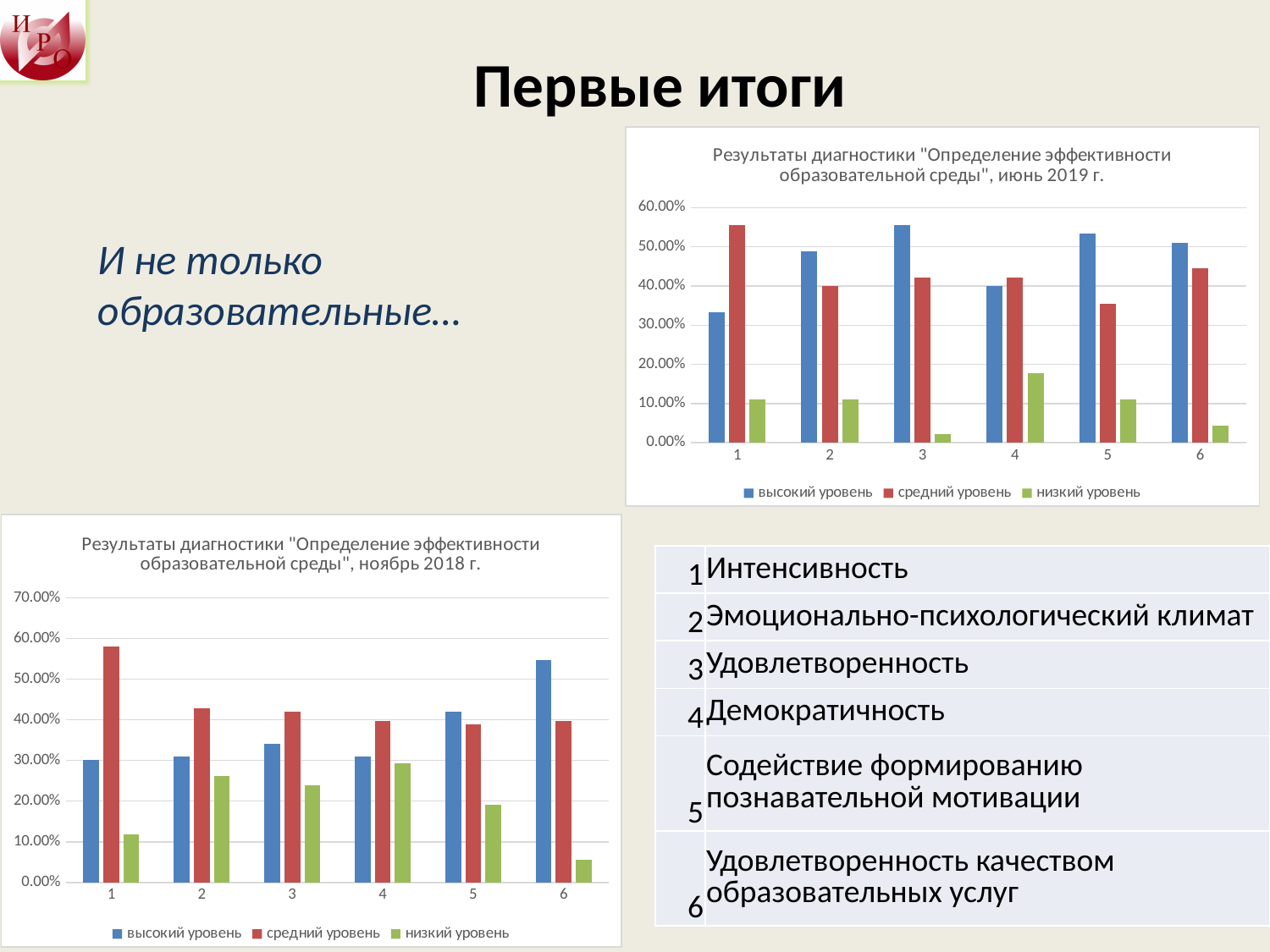
In the bottom-left chart (ноябрь 2018 г.), which category has the highest value for "высокий уровень"? 6 In the top-right chart (июнь 2019 г.), which category has the lowest value for "низкий уровень"? 3 What kind of chart is the top-right chart titled "Результаты диагностики ... июнь 2019 г."? bar chart What colour represents "низкий уровень" in the legend of the top-right chart (июнь 2019 г.)? green How many categories are shown on the x axis of the top-right chart (июнь 2019 г.)? 6 In the bottom-left chart (ноябрь 2018 г.), which category has the highest value for "средний уровень"? 1 In the top-right chart (июнь 2019 г.), is the value of "низкий уровень" for category 4 greater or less than 10.00%? greater In the bottom-left chart (ноябрь 2018 г.), is the value of "средний уровень" for category 1 greater or less than 50.00%? greater In the top-right chart (июнь 2019 г.), is the value of "высокий уровень" for category 1 greater or less than 40.00%? less In the top-right chart (июнь 2019 г.), for category 1, which is larger: "высокий уровень" or "средний уровень"? средний уровень How many series does the legend of the bottom-left chart (ноябрь 2018 г.) list? 3 In the bottom-left chart (ноябрь 2018 г.), for category 6, which is larger: "высокий уровень" or "средний уровень"? высокий уровень